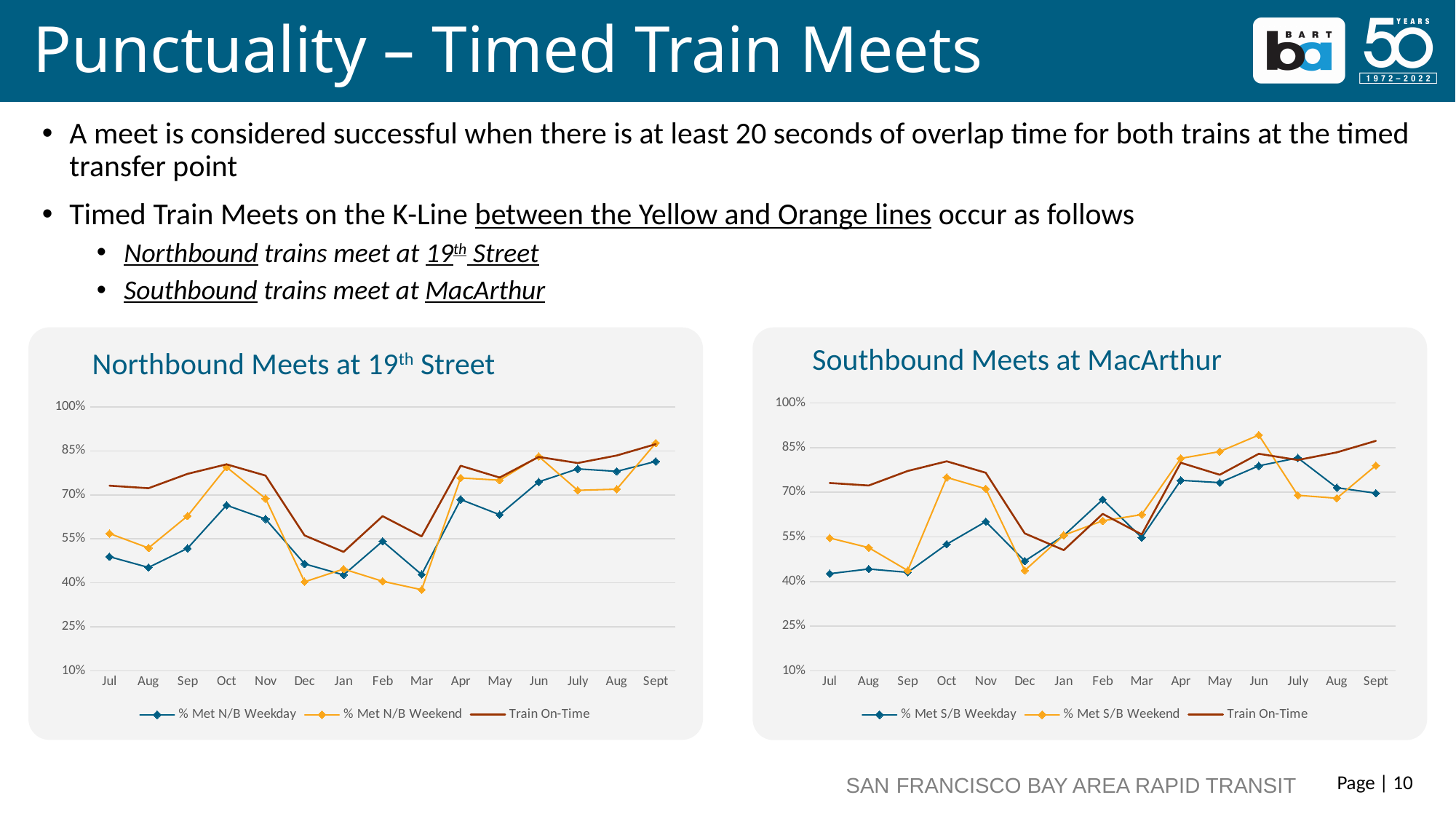
What kind of chart is the Northbound Meets at 19th Street chart? Line chart In the Northbound Meets at 19th Street chart, which is larger in Oct: % Met N/B Weekday or % Met N/B Weekend? % Met N/B Weekend In the Southbound Meets at MacArthur chart, is the Train On-Time value for Sept greater or less than 85%? greater What are the three legend entries of the Northbound Meets at 19th Street chart? % Met N/B Weekday, % Met N/B Weekend, Train On-Time In the Northbound Meets at 19th Street chart, is the % Met N/B Weekend value for Mar greater or less than 40%? less How many months are plotted along the x axis of the Northbound Meets at 19th Street chart? 15 In the Northbound Meets at 19th Street chart, which month has the highest % Met N/B Weekend value? Sept In the Southbound Meets at MacArthur chart, which month has the highest % Met S/B Weekend value? Jun In the Southbound Meets at MacArthur chart, is the % Met S/B Weekend value for Jun greater or less than 85%? greater How many series does the legend of the Southbound Meets at MacArthur chart list? 3 In the Southbound Meets at MacArthur chart, does the % Met S/B Weekend value rise or fall from Jun to July? Fall